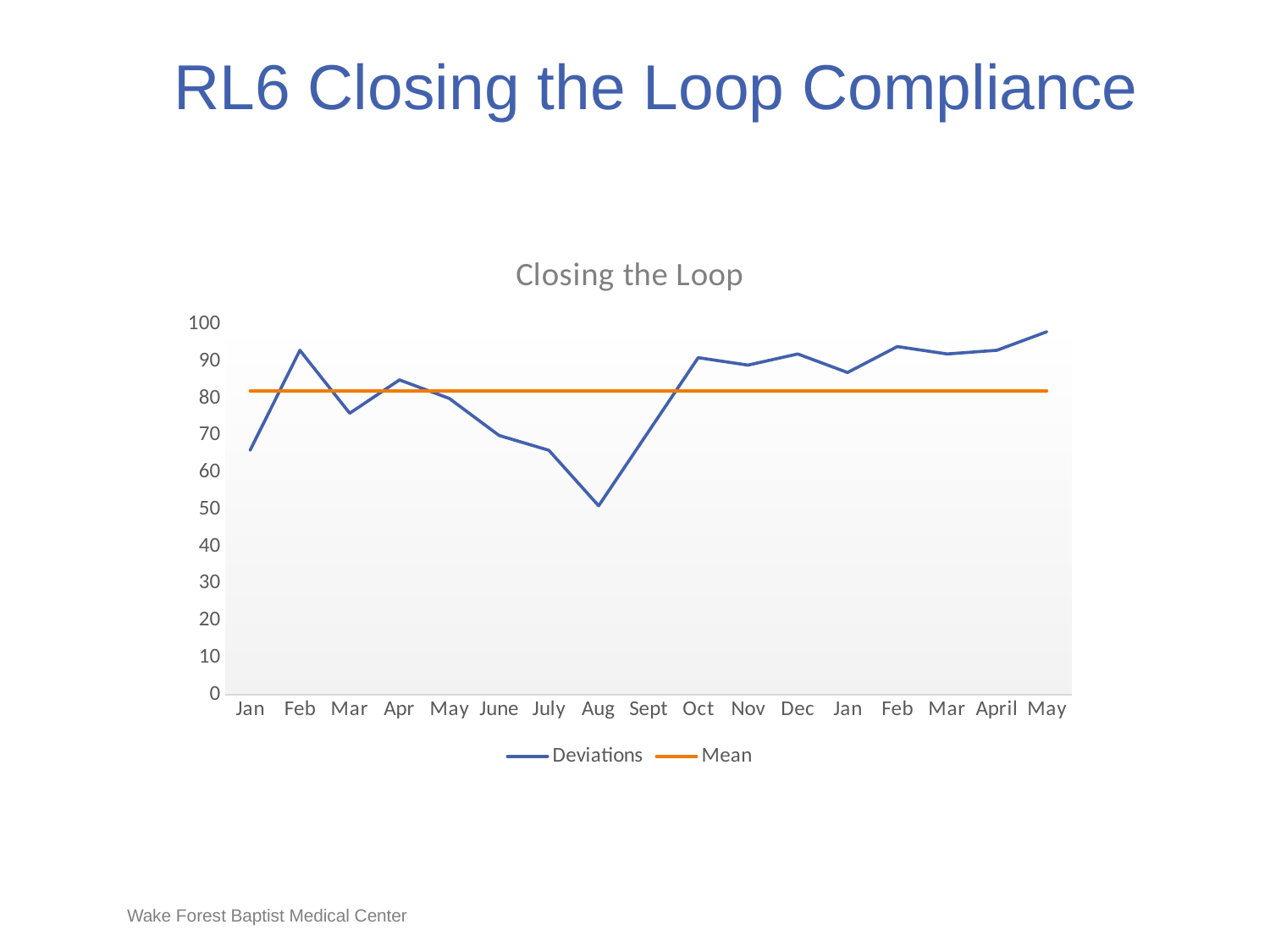
Do the Deviations values rise or fall from Apr to Aug? fall Which series is drawn in orange? Mean Is the Deviations value for Oct greater or less than 80? greater Which month has the lowest Deviations value? Aug How many series does the legend list? 2 What is the title of the chart? Closing the Loop Is the Deviations value for July greater or less than 70? less How many points are plotted along the x axis for the Deviations series? 17 Is the Deviations value for Aug greater or less than 60? less Which is larger, the Deviations value for Sept or for Oct? Oct What kind of chart is shown on the slide? Line chart